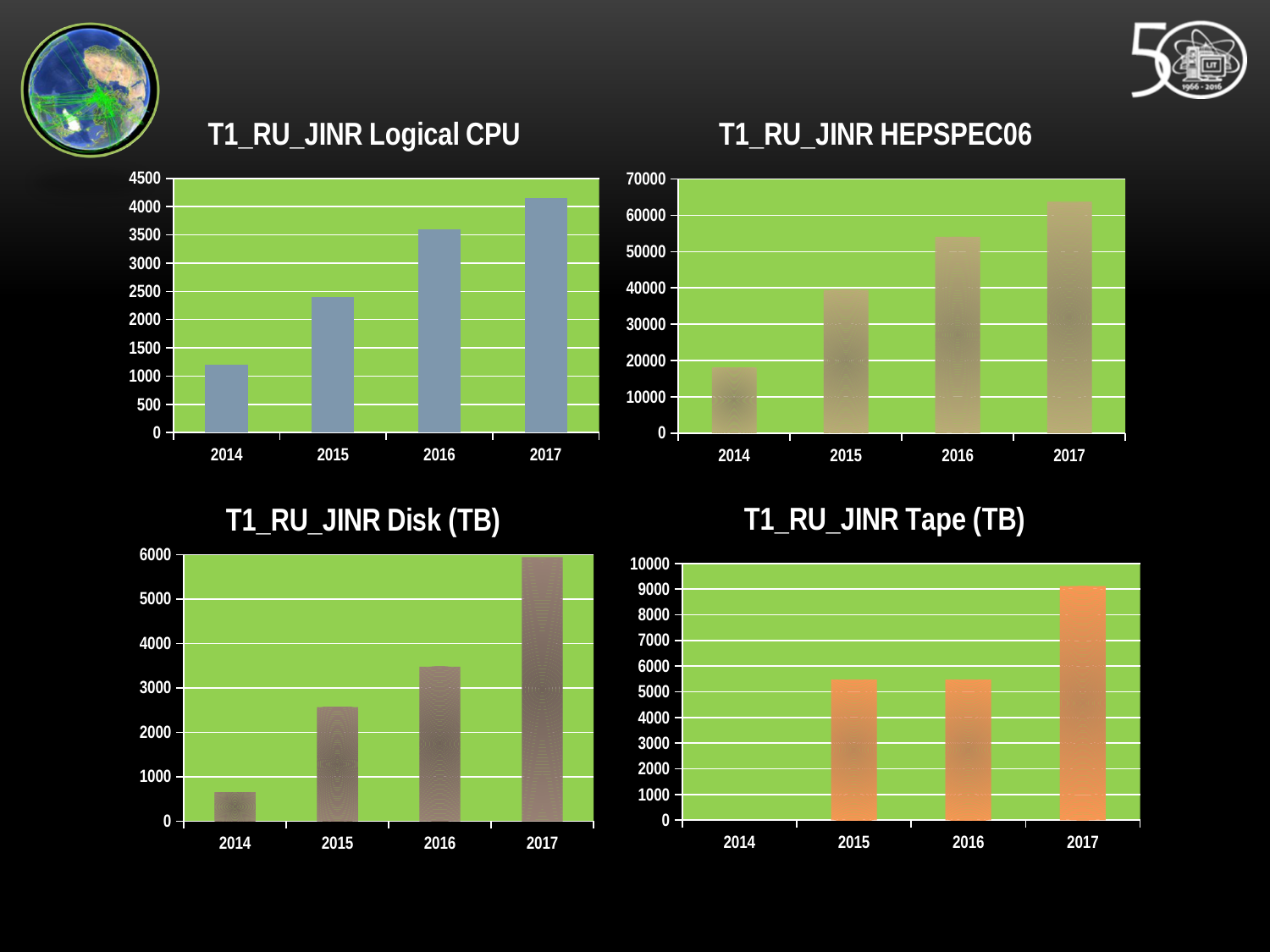
In the T1_RU_JINR Logical CPU chart, which is larger, the value for 2015 or the value for 2016? 2016 In the T1_RU_JINR Tape (TB) chart, is the value for 2017 greater or less than 8000? greater In the T1_RU_JINR Disk (TB) chart, which year has the lowest value? 2014 In the T1_RU_JINR HEPSPEC06 chart, is the value for 2015 greater or less than 30000? greater In the T1_RU_JINR Logical CPU chart, is the value for 2014 greater or less than 1500? less In the T1_RU_JINR HEPSPEC06 chart, which year has the lowest value? 2014 How many years are shown on the x axis of the T1_RU_JINR Logical CPU chart? 4 In the T1_RU_JINR HEPSPEC06 chart, do the values rise or fall from 2014 to 2017? rise In the T1_RU_JINR Tape (TB) chart, which year has the highest value? 2017 What kind of chart is the T1_RU_JINR Tape (TB) chart? bar chart In the T1_RU_JINR Logical CPU chart, which year has the highest value? 2017